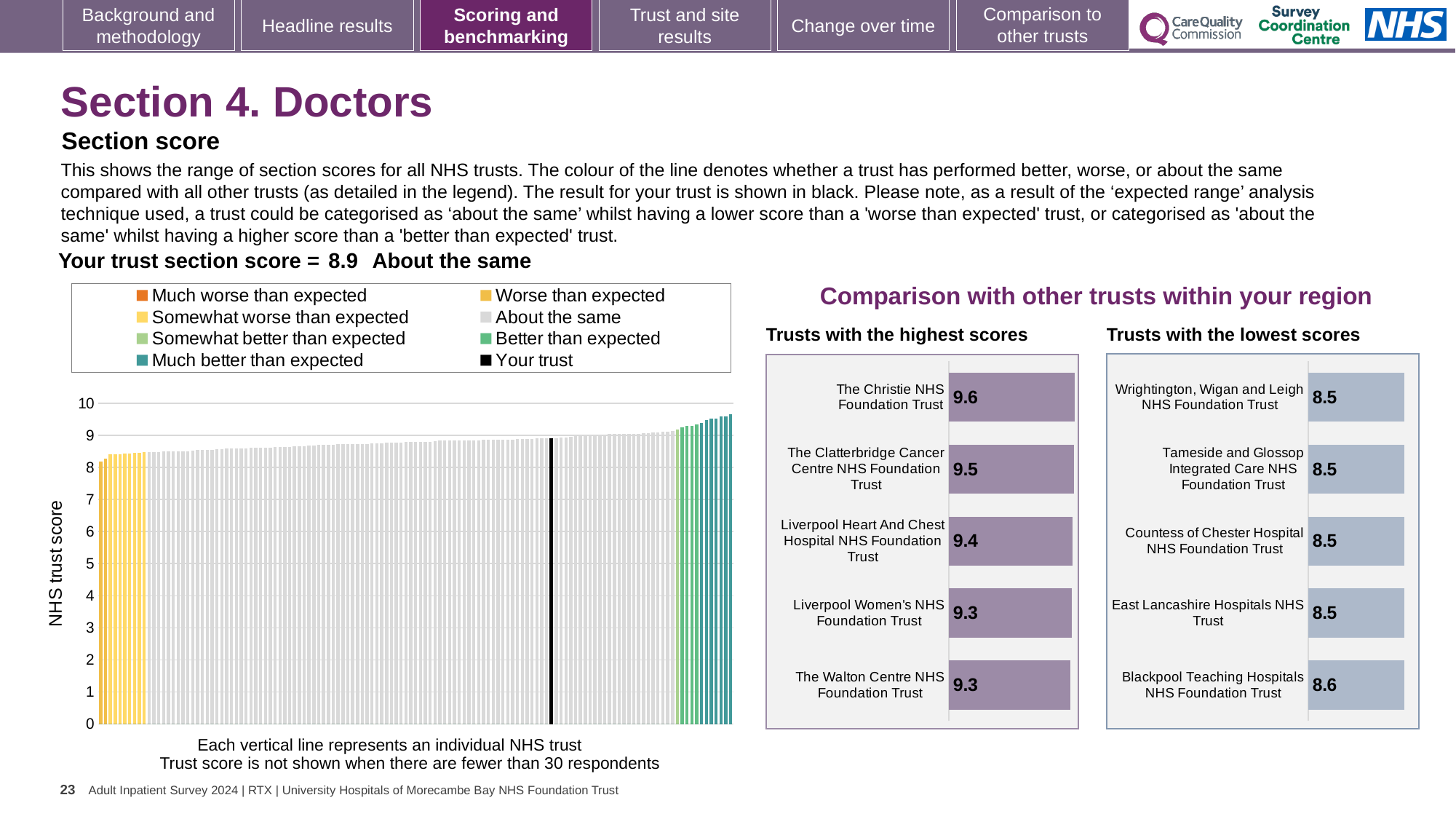
In the 'Trusts with the highest scores' chart, what is the score for Liverpool Heart And Chest Hospital NHS Foundation Trust? 9.4 In the 'Trusts with the lowest scores' chart, what is the score for Blackpool Teaching Hospitals NHS Foundation Trust? 8.6 In the 'Trusts with the highest scores' chart, which trust has the highest score? The Christie NHS Foundation Trust How many entries does the legend of the NHS trust score chart on the left list? 8 What kind of chart is the 'Trusts with the lowest scores' chart? bar chart In the 'Trusts with the lowest scores' chart, which trust has the highest score? Blackpool Teaching Hospitals NHS Foundation Trust In the 'Trusts with the highest scores' chart, what is the difference between the scores of The Christie NHS Foundation Trust and The Walton Centre NHS Foundation Trust? 0.3 In the 'Trusts with the highest scores' chart, which has the higher score: The Clatterbridge Cancer Centre NHS Foundation Trust or Liverpool Women's NHS Foundation Trust? The Clatterbridge Cancer Centre NHS Foundation Trust How many trusts are shown in the 'Trusts with the highest scores' chart? 5 In the NHS trust score chart on the left, what colour is used for 'Your trust' according to the legend? black How many trusts are shown in the 'Trusts with the lowest scores' chart? 5 In the 'Trusts with the highest scores' chart, what is the score for The Christie NHS Foundation Trust? 9.6